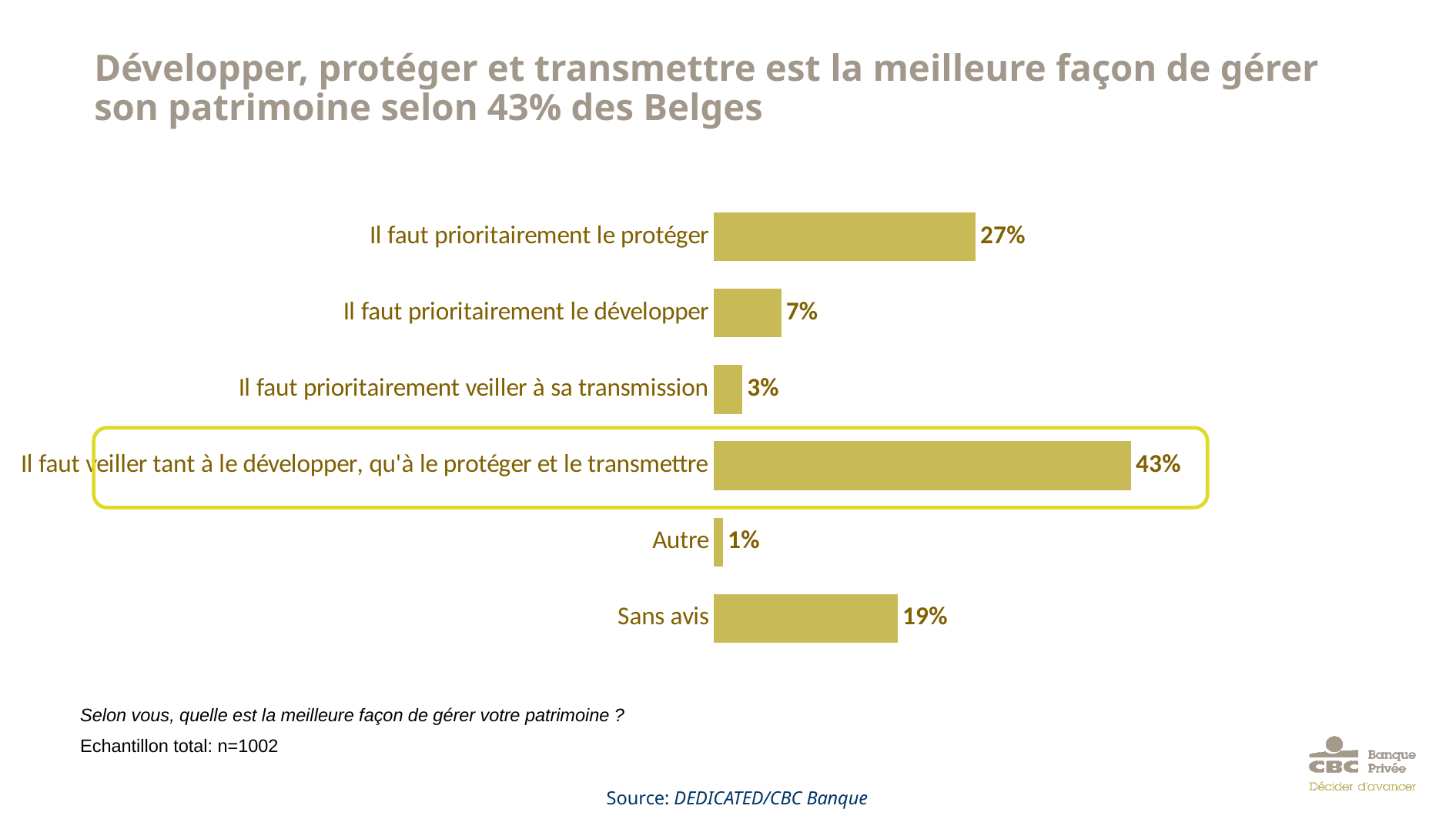
What percentage is shown for "Il faut prioritairement veiller à sa transmission"? 3% Which category has the highest value? Il faut veiller tant à le développer, qu'à le protéger et le transmettre Which category is highlighted with a yellow outline box? Il faut veiller tant à le développer, qu'à le protéger et le transmettre What kind of chart is shown on the slide? Bar chart What is the sample size stated on the slide? n=1002 What percentage of respondents chose "Il faut prioritairement le protéger"? 27% Which category has the lowest value? Autre Which is larger: the value for "Sans avis" or the value for "Il faut prioritairement le développer"? Sans avis What is the difference between the values for "Il faut prioritairement le protéger" and "Il faut prioritairement le développer"? 20% How many categories are shown in the chart? 6 What is the value shown for "Sans avis"? 19% What is the difference between the highest value (43%) and "Sans avis" (19%)? 24%